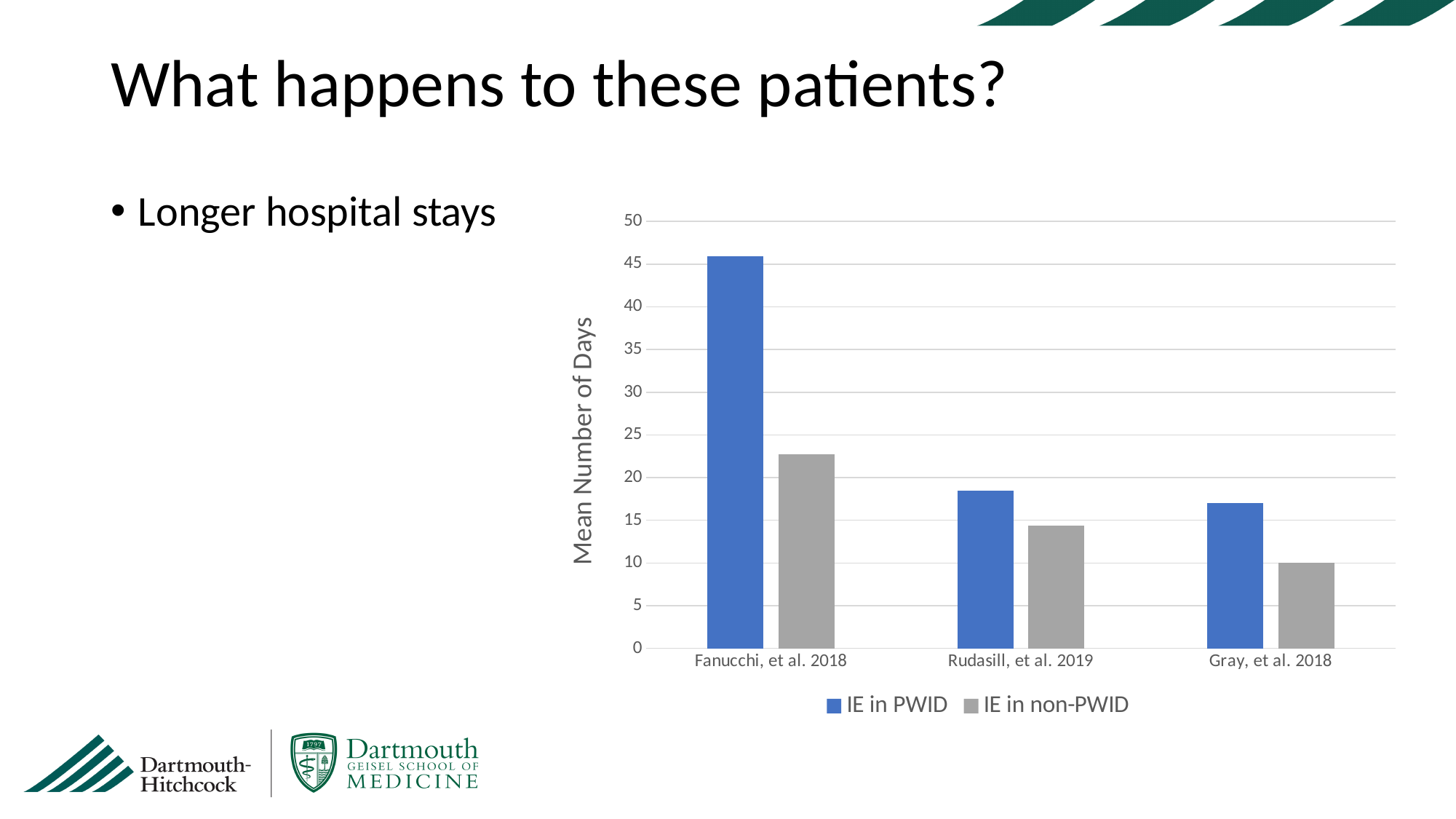
Is the value for IE in non-PWID in Rudasill, et al. 2019 greater or less than 10? greater How many study categories are shown on the x axis? 3 Is the value for IE in PWID in Fanucchi, et al. 2018 greater or less than 40? greater Which colour represents IE in non-PWID in the legend? gray Is the value for IE in non-PWID in Fanucchi, et al. 2018 greater or less than 25? less Which is larger for Gray, et al. 2018: IE in PWID or IE in non-PWID? IE in PWID What kind of chart is shown on the slide? bar chart Which study has the highest value for IE in PWID? Fanucchi, et al. 2018 What is the label of the y axis? Mean Number of Days Which study has the lowest value for IE in non-PWID? Gray, et al. 2018 How many series does the legend list? 2